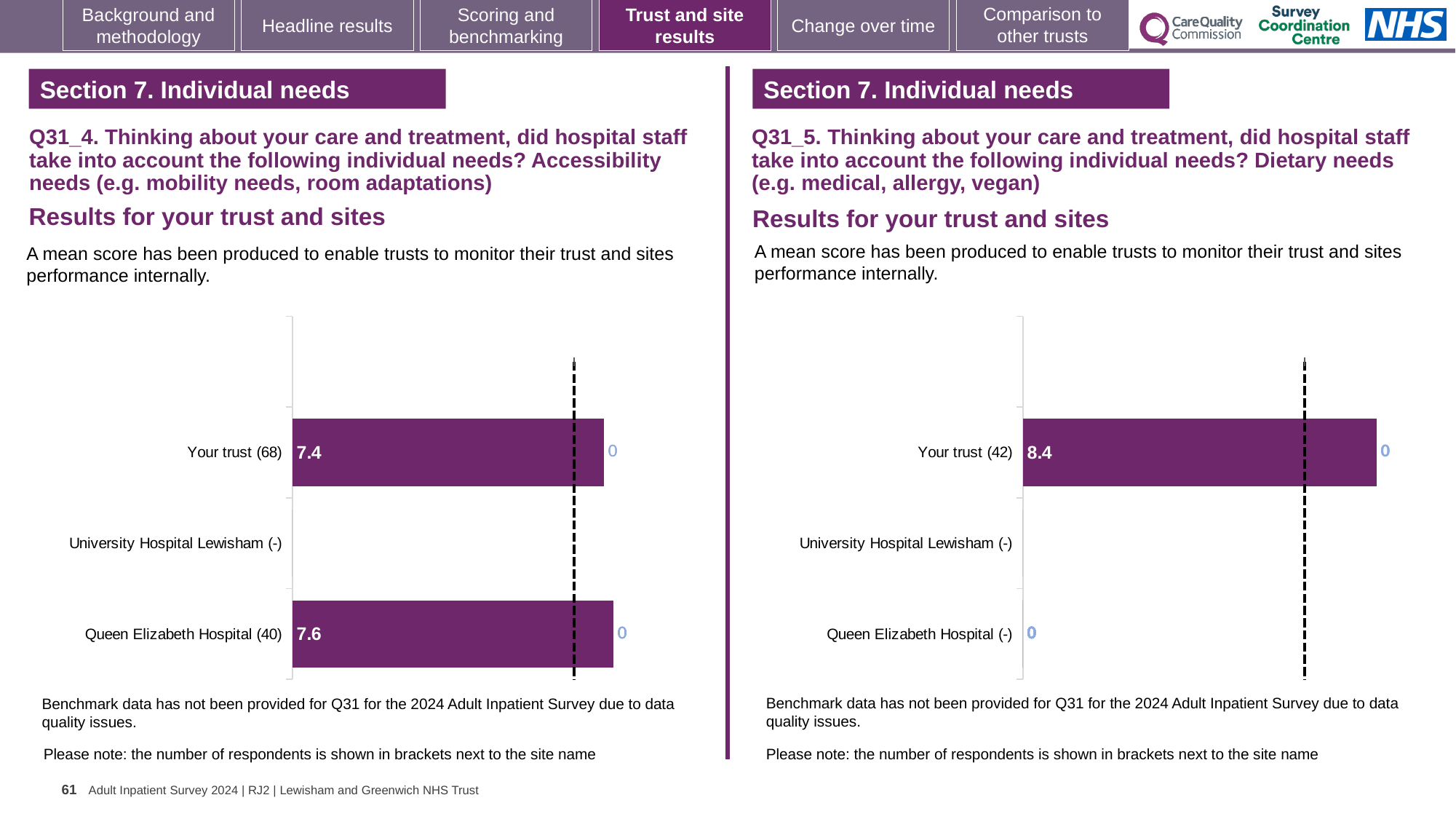
In the right chart (Q31_5), how many respondents are shown in brackets for Your trust? 42 How many categories are listed on the vertical axis of the left chart (Q31_4)? 3 In the right chart (Q31_5, dietary needs), how many sites have a plotted bar? 1 In the left chart (Q31_4, accessibility needs), what is the mean score for Your trust? 7.4 In the left chart (Q31_4), how many respondents are shown in brackets for Your trust? 68 In the left chart (Q31_4, accessibility needs), which site has the higher mean score, Your trust or Queen Elizabeth Hospital? Queen Elizabeth Hospital What type of chart is used on the right side of the slide (Q31_5)? Bar chart In the right chart (Q31_5, dietary needs), what is the mean score for Your trust? 8.4 In the left chart (Q31_4, accessibility needs), which plotted bar has the lowest mean score? Your trust In the left chart (Q31_4, accessibility needs), what is the difference between the Queen Elizabeth Hospital score and the Your trust score? 0.2 Which section heading appears above both charts on the slide? Section 7. Individual needs In the left chart (Q31_4, accessibility needs), what is the mean score for Queen Elizabeth Hospital? 7.6